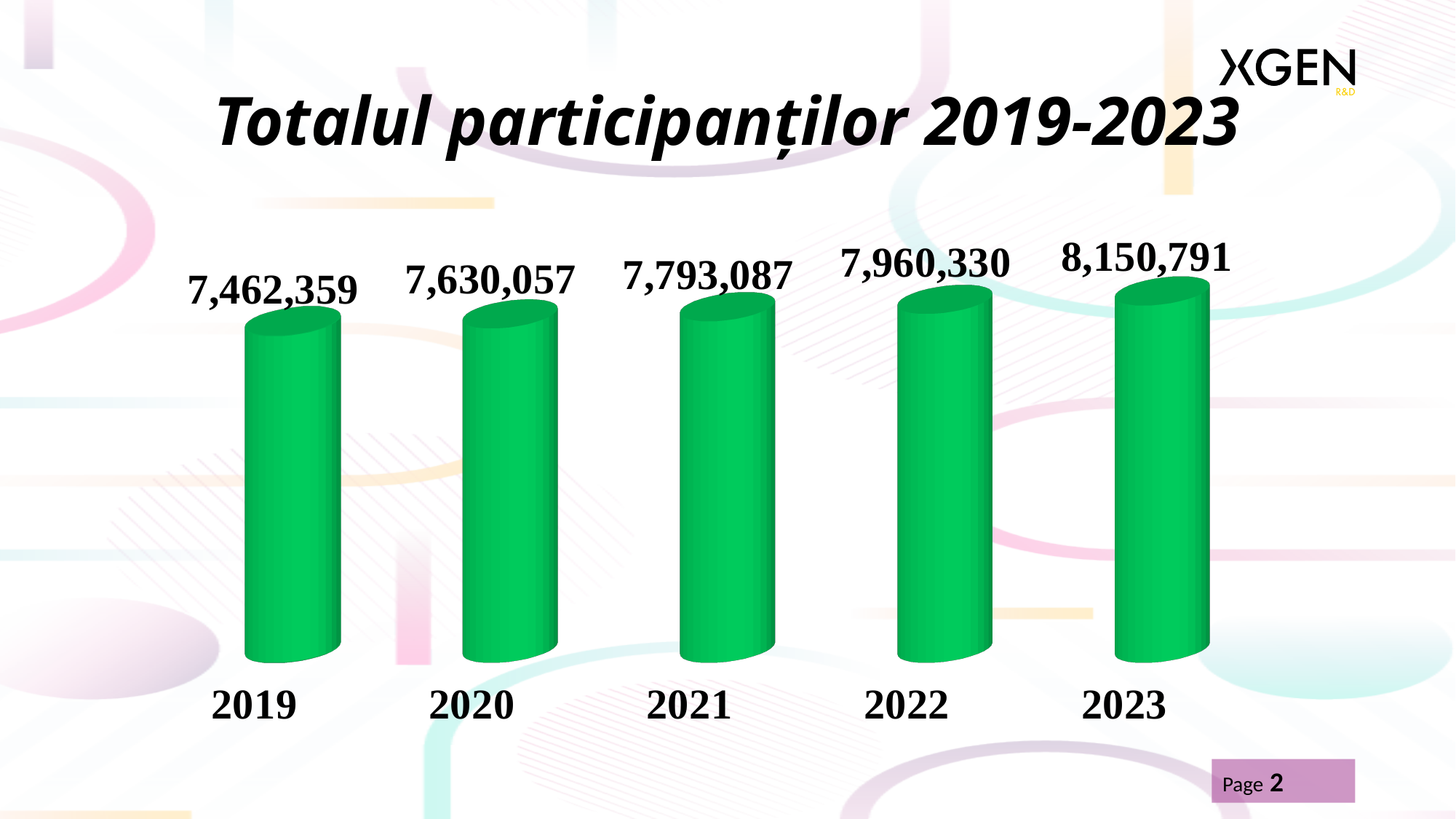
How many years are shown in the chart? 5 What is the difference between the values for 2023 and 2019? 688,432 Do the values rise or fall from 2019 to 2023? Rise What is the value for 2019? 7,462,359 Which year has the lowest value? 2019 What is the value for 2022? 7,960,330 What is the value for 2021? 7,793,087 What is the difference between the values for 2020 and 2019? 167,698 Which is larger, the value for 2021 or the value for 2022? 2022 Which year has the highest value? 2023 What is the value for 2023? 8,150,791 What kind of chart is shown on the slide? Bar chart